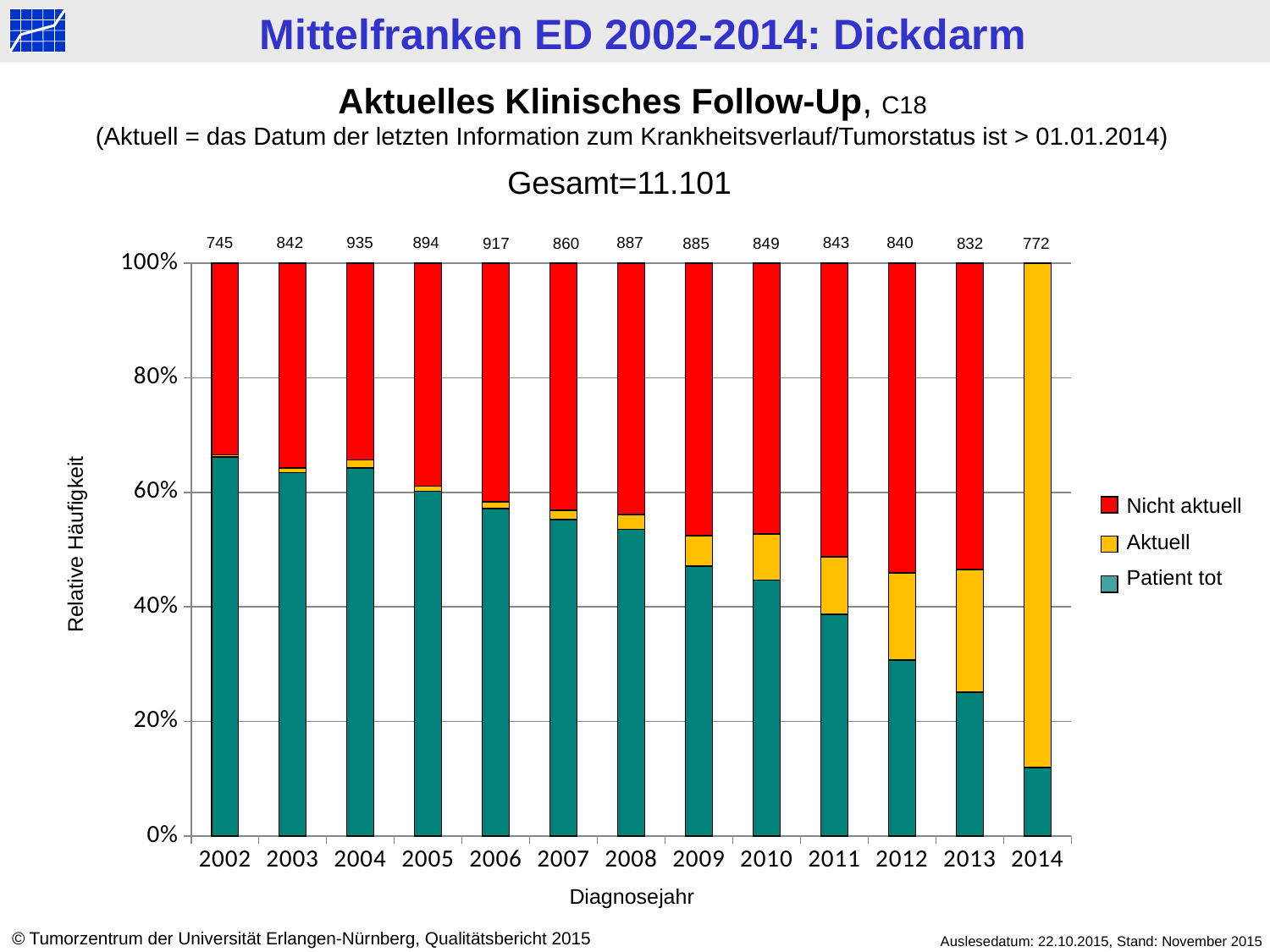
How many diagnosis years are shown on the x axis? 13 How many series does the legend list? 3 Which diagnosis year has the lowest number printed above its bar? 2002 What is the number printed above the bar for 2004? 935 Is the 'Patient tot' share for 2014 greater or less than 20%? less What is the number printed above the bar for 2009? 885 What is the number printed above the bar for 2014? 772 Is the 'Patient tot' share for 2002 greater or less than 60%? greater Which year has the larger number printed above its bar, 2003 or 2005? 2005 Which diagnosis year has the highest number printed above its bar? 2004 Does the 'Patient tot' share rise or fall from 2002 to 2014? fall What is the difference between the numbers printed above the bars for 2004 and 2002? 190